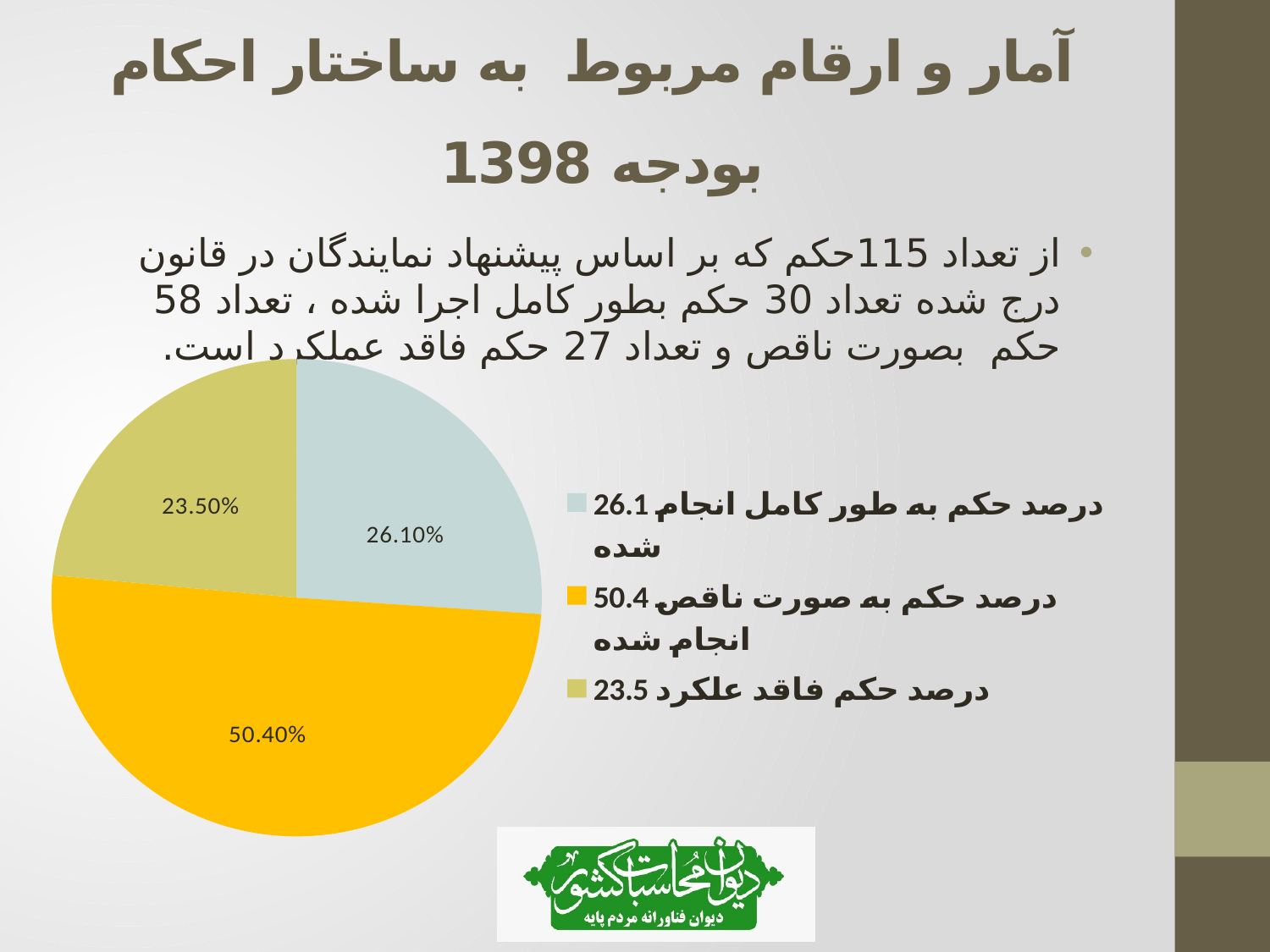
Which slice of the pie chart is the largest? درصد حکم به صورت ناقص انجام شده 50.4 Which slice of the pie chart is the smallest? درصد حکم فاقد علکرد 23.5 How many entries does the legend of the pie chart list? 3 How many slices does the pie chart have? 3 What percentage is shown for the slice labelled 'درصد حکم فاقد علکرد 23.5'? 23.50% What percentage is shown for the slice labelled 'درصد حکم به صورت ناقص انجام شده 50.4'? 50.40% What percentage is shown for the slice labelled 'درصد حکم به طور کامل انجام شده 26.1'? 26.10% Which is larger: the slice for 'درصد حکم به طور کامل انجام شده 26.1' or the slice for 'درصد حکم فاقد علکرد 23.5'? درصد حکم به طور کامل انجام شده 26.1 What is the difference between the 50.40% slice and the 23.50% slice? 26.90% What kind of chart is shown on the slide? pie chart What colour is the slice representing 50.40%? yellow What is the difference between the 26.10% slice and the 23.50% slice? 2.60%